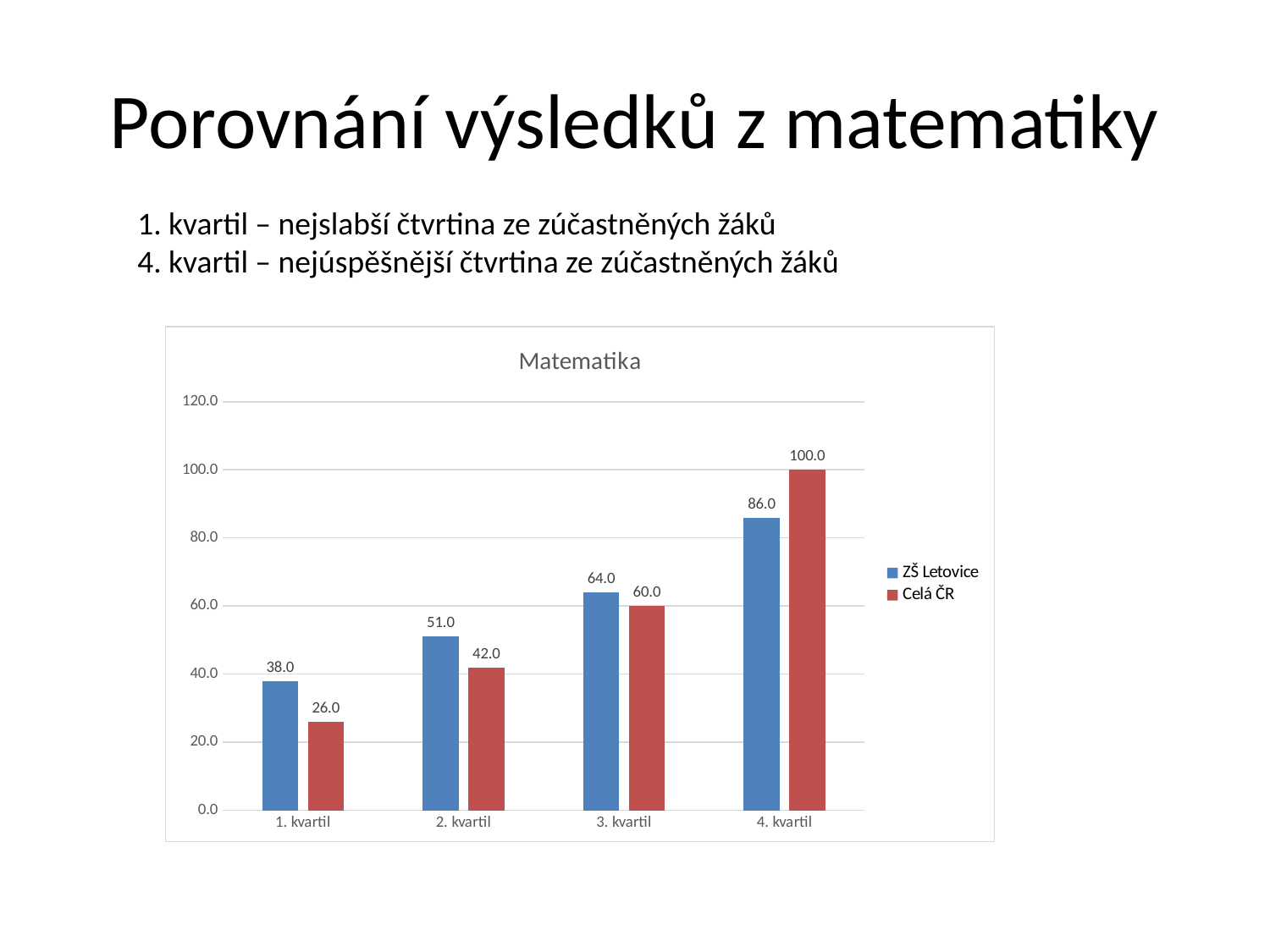
Which category has the highest value for ZŠ Letovice? 4. kvartil Which is larger in 3. kvartil, ZŠ Letovice or Celá ČR? ZŠ Letovice How many series does the legend list? 2 What is the difference between ZŠ Letovice and Celá ČR in 1. kvartil? 12.0 Which category has the lowest value for Celá ČR? 1. kvartil Do the values for Celá ČR rise or fall from 1. kvartil to 4. kvartil? rise What is the value for ZŠ Letovice in 1. kvartil? 38.0 What kind of chart is shown? bar chart How many categories are shown on the x axis? 4 What is the difference between Celá ČR and ZŠ Letovice in 4. kvartil? 14.0 What is the value for Celá ČR in 2. kvartil? 42.0 What is the value for Celá ČR in 4. kvartil? 100.0